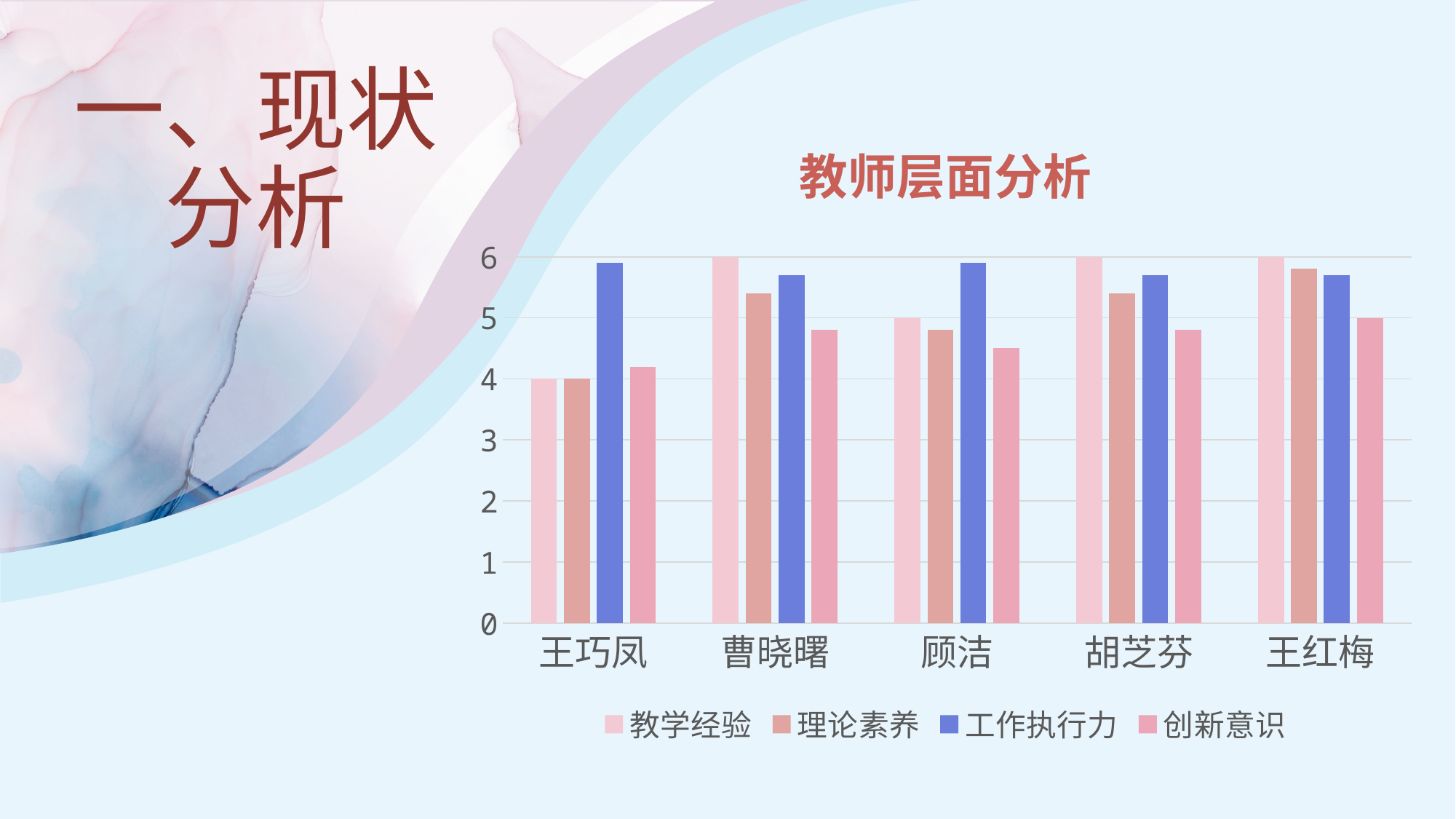
Which teacher has the lowest 教学经验 value? 王巧凤 How many teachers (categories) are shown on the x axis? 5 What is the title of the chart? 教师层面分析 Which series is shown in blue in the legend? 工作执行力 How many series does the legend list? 4 Which is larger for 王巧凤: 工作执行力 or 创新意识? 工作执行力 Is the 工作执行力 value for 王巧凤 greater or less than 5? greater What is the 教学经验 value for 曹晓曙? 6 What kind of chart is shown on the slide? bar chart Is the 创新意识 value for 顾洁 greater or less than 5? less What is the 教学经验 value for 顾洁? 5 What is the 教学经验 value for 王巧凤? 4